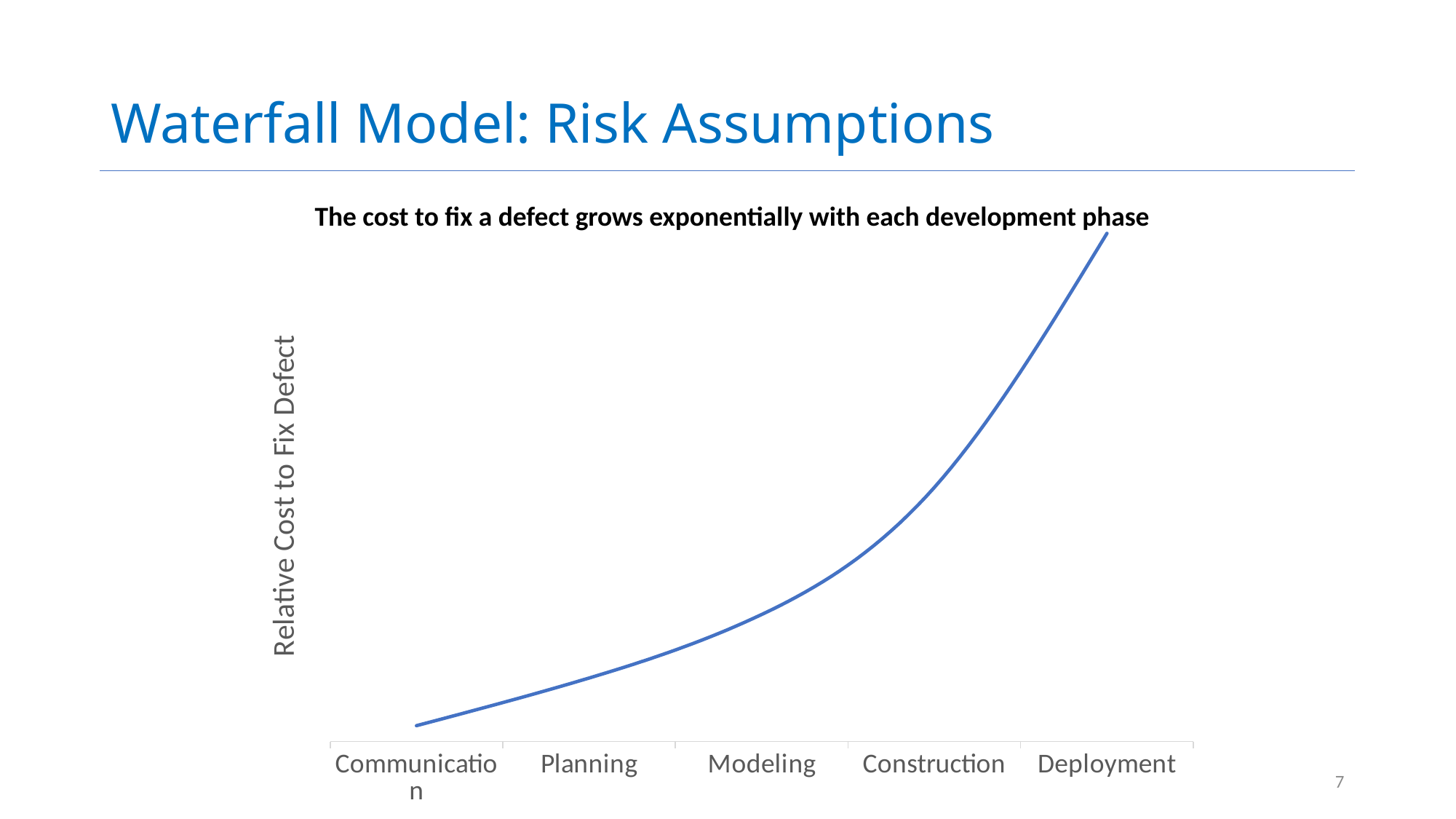
What is the label on the vertical axis of the chart? Relative Cost to Fix Defect Which phase has the highest relative cost to fix a defect? Deployment Does the relative cost to fix a defect rise or fall from Communication to Deployment? rise Which phase comes immediately after Modeling on the x axis? Construction Which phase has the lowest relative cost to fix a defect? Communication Which has a higher relative cost to fix a defect, Modeling or Construction? Construction What is the title of the chart? The cost to fix a defect grows exponentially with each development phase Which has a lower relative cost to fix a defect, Planning or Deployment? Planning How many development phases are shown on the x axis? 5 What kind of chart is shown on the slide? line chart